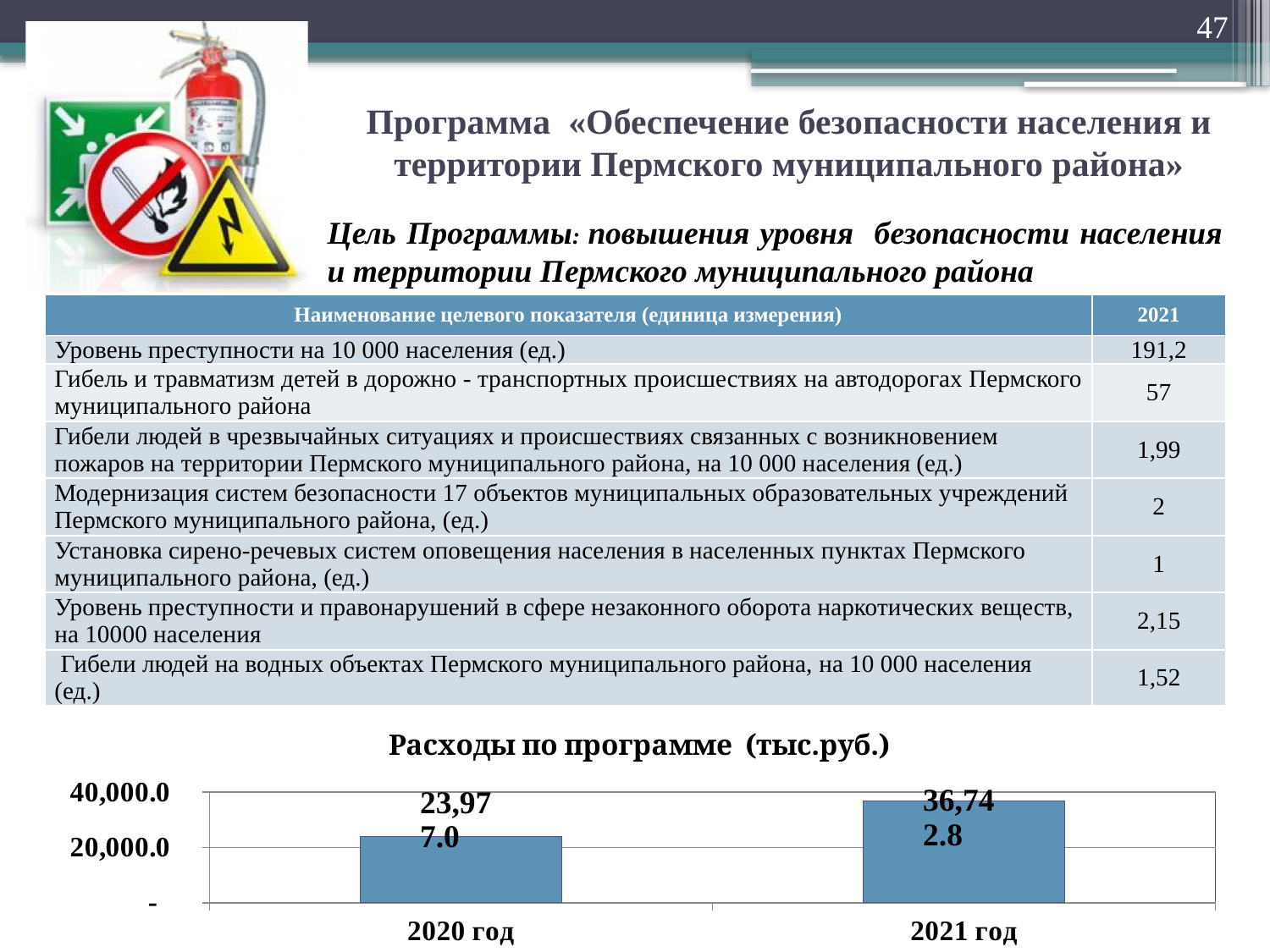
Is the value for 2021 год in the chart "Расходы по программе (тыс.руб.)" greater or less than 40,000.0? less Do the values in the chart "Расходы по программе (тыс.руб.)" rise or fall from 2020 год to 2021 год? rise Which year has the lower value in the chart "Расходы по программе (тыс.руб.)"? 2020 год What is the value for 2021 год in the chart "Расходы по программе (тыс.руб.)"? 36,742.8 What is the value for 2020 год in the chart "Расходы по программе (тыс.руб.)"? 23,977.0 Which year has the higher value in the chart "Расходы по программе (тыс.руб.)"? 2021 год Is the value for 2020 год in the chart "Расходы по программе (тыс.руб.)" greater or less than 20,000.0? greater What is the title of the bar chart at the bottom of the slide? Расходы по программе (тыс.руб.) What is the difference between the 2021 год and 2020 год values in the chart "Расходы по программе (тыс.руб.)"? 12,765.8 How many bars (categories) does the chart "Расходы по программе (тыс.руб.)" show? 2 In the chart "Расходы по программе (тыс.руб.)", is the value for 2021 год larger or smaller than the value for 2020 год? larger What type of chart is shown under the title "Расходы по программе (тыс.руб.)"? bar chart